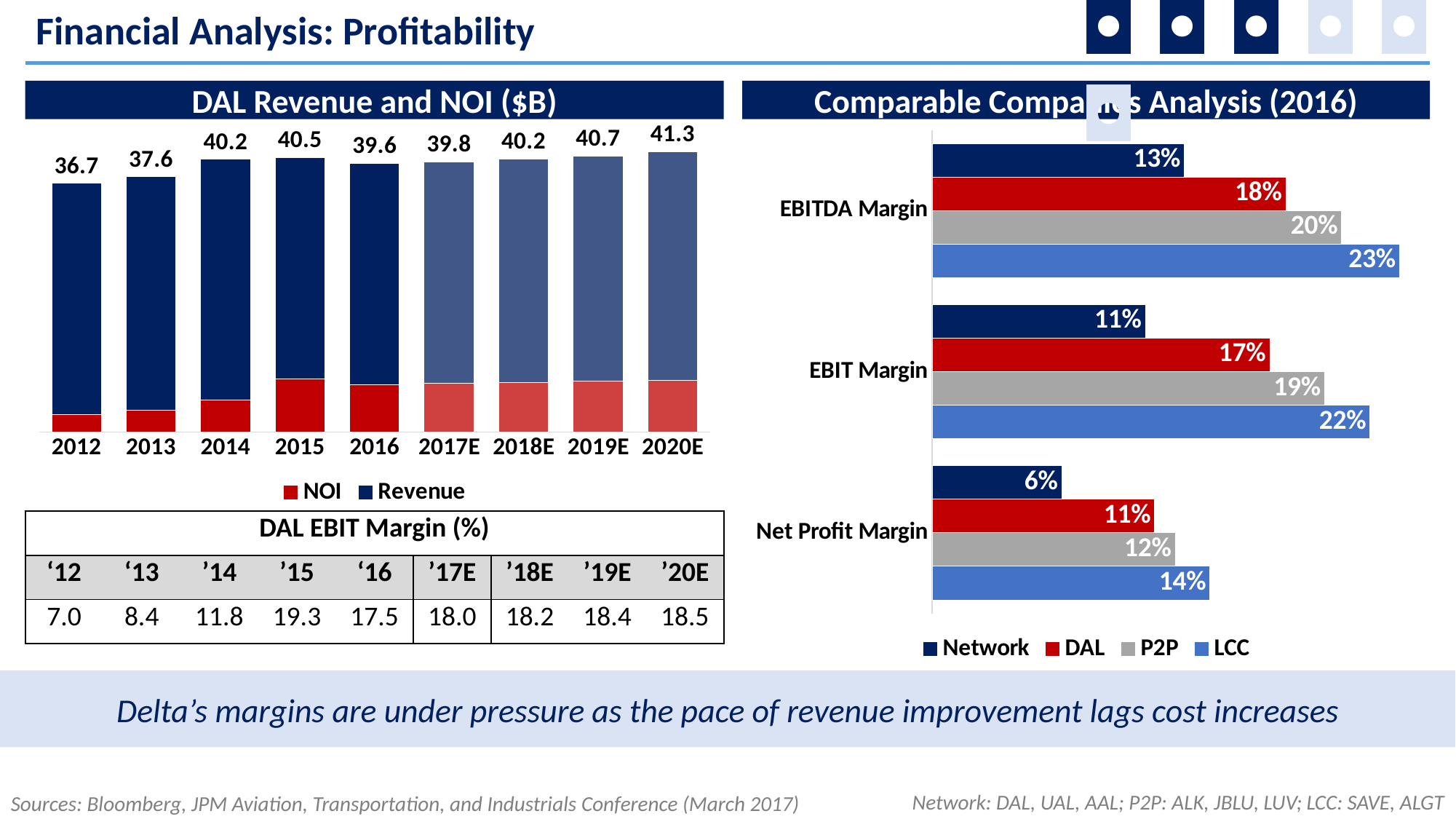
How many margin categories are shown in the Comparable Companies Analysis (2016) chart? 3 In the DAL Revenue and NOI ($B) chart, what value is printed above the 2020E bar? 41.3 In the Comparable Companies Analysis (2016) chart, which group has the lowest Net Profit Margin? Network In the Comparable Companies Analysis (2016) chart, which group has the highest EBITDA Margin? LCC In the Comparable Companies Analysis (2016) chart, what is the difference between the EBIT Margin of LCC and that of Network? 11 percentage points What kind of chart is the DAL Revenue and NOI ($B) chart? Stacked bar chart In the Comparable Companies Analysis (2016) chart, what is the Net Profit Margin for Network? 6% In the Comparable Companies Analysis (2016) chart, which has the larger Net Profit Margin, DAL or P2P? P2P How many years are shown on the x axis of the DAL Revenue and NOI ($B) chart? 9 In the Comparable Companies Analysis (2016) chart, what is the EBIT Margin for DAL? 17% How many series does the legend of the Comparable Companies Analysis (2016) chart list? 4 In the Comparable Companies Analysis (2016) chart, what is the EBITDA Margin for LCC? 23%